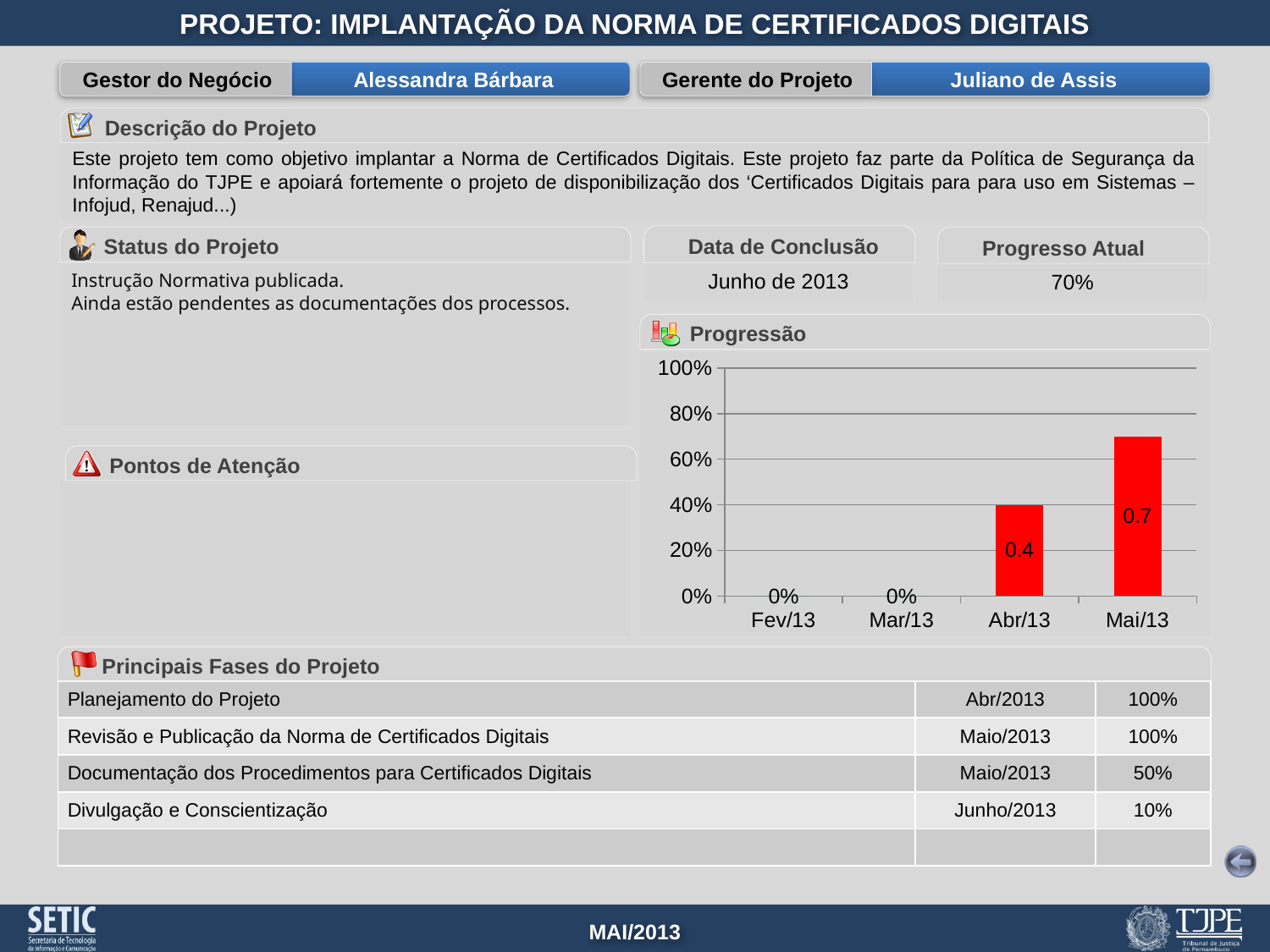
In the Progressão chart, is the value for Mai/13 greater or less than 60%? greater In the Progressão chart, what value is labelled for Fev/13? 0% What type of chart is shown under the heading "Progressão"? bar chart In the Progressão chart, do the values rise or fall from Fev/13 to Mai/13? rise In the Progressão chart, what is the value shown for Mai/13? 0.7 How many months are shown on the x axis of the Progressão chart? 4 In the Progressão chart, is the value for Abr/13 greater or less than 60%? less In the Progressão chart, what value is labelled for Mar/13? 0% In the Progressão chart, what is the value shown for Abr/13? 0.4 In the Progressão chart, what is the difference between the values for Mai/13 and Abr/13? 0.3 In the Progressão chart, which is larger, the value for Abr/13 or the value for Mai/13? Mai/13 In the Progressão chart, which month has the highest value? Mai/13